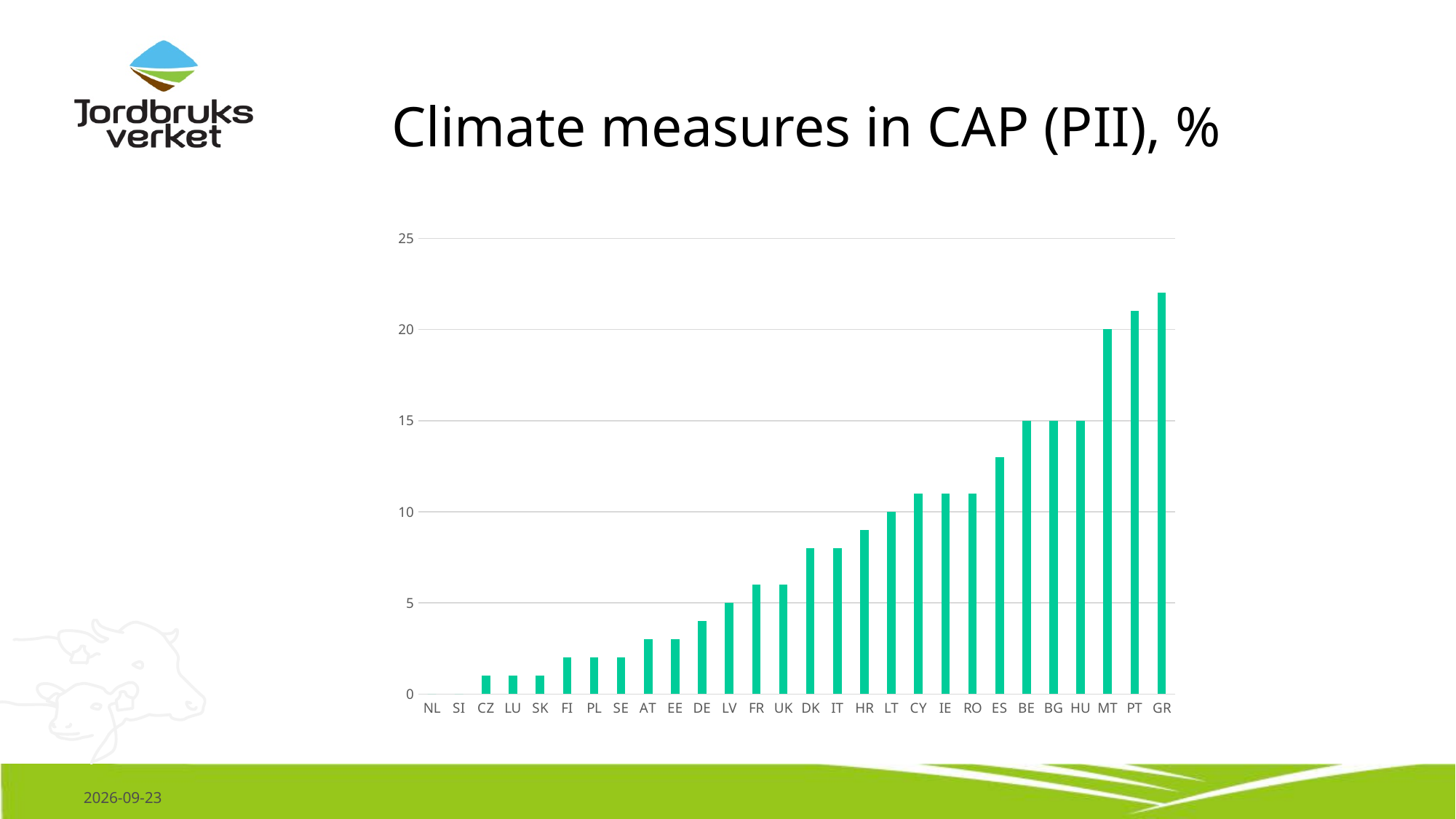
What kind of chart is shown on the slide? bar chart Which has a larger value, PT or DK? PT What is the value for MT? 20 Is the value for GR greater or less than 20? greater What is the title of the chart? Climate measures in CAP (PII), % Which country has the highest value in the chart? GR What is the value for LV? 5 Do the values rise or fall from left to right along the x axis? rise Is the value for ES greater or less than 15? less How many countries are listed along the x axis of the chart? 28 What is the value for LT? 10 What is the difference between the values for MT and LT? 10